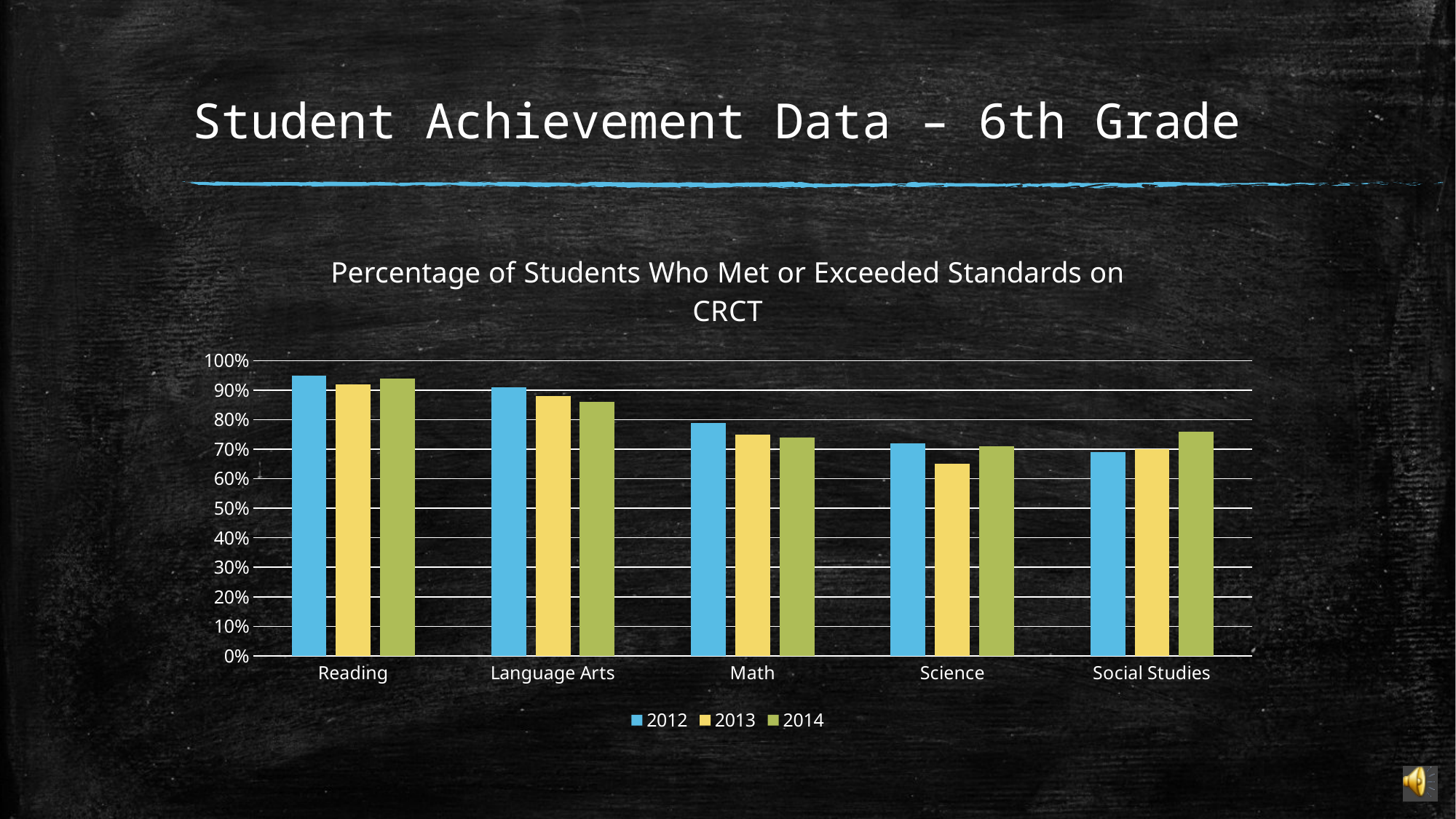
Which subject has the highest 2012 value? Reading Which year does the green series in the legend represent? 2014 Which subject has the lowest 2013 value? Science How many subject categories are shown on the x axis of the chart? 5 Is the 2013 value for Science greater or less than 70%? less For Social Studies, which year has the larger value, 2012 or 2014? 2014 What is the title of the chart? Percentage of Students Who Met or Exceeded Standards on CRCT How many series does the chart's legend list? 3 Is the 2014 value for Social Studies greater or less than 70%? greater What kind of chart is shown on the slide? Bar chart Is the 2012 value for Reading greater or less than 90%? greater